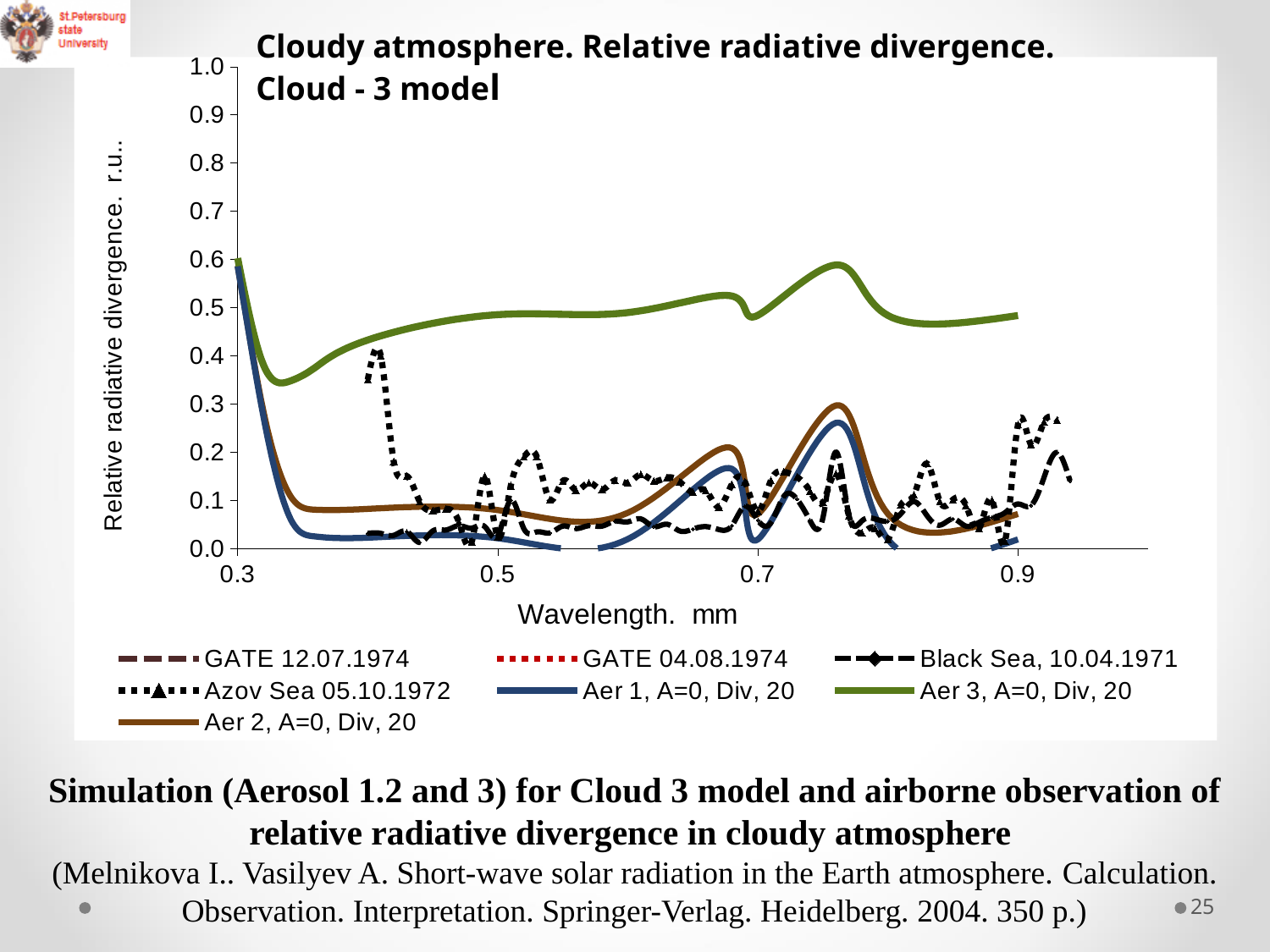
Is the value of the Aer 1, A=0, Div, 20 series at wavelength 0.5 greater or less than 0.1? less What is the title of the chart? Cloudy atmosphere. Relative radiative divergence. Cloud - 3 model Is the peak value of the Aer 3, A=0, Div, 20 series between wavelengths 0.7 and 0.9 greater or less than 0.5? greater How many series does the legend list? 7 Is the value of the Aer 3, A=0, Div, 20 series at wavelength 0.5 greater or less than 0.4? greater What kind of chart is shown on the slide? line chart What is the highest value shown on the y axis? 1.0 At wavelength 0.7, which series has the larger value: Aer 3, A=0, Div, 20 or Aer 2, A=0, Div, 20? Aer 3, A=0, Div, 20 Which series has the highest values across the wavelength range? Aer 3, A=0, Div, 20 What is the label of the x axis? Wavelength. mm Does the Aer 1, A=0, Div, 20 series rise or fall between wavelengths 0.3 and 0.5? fall